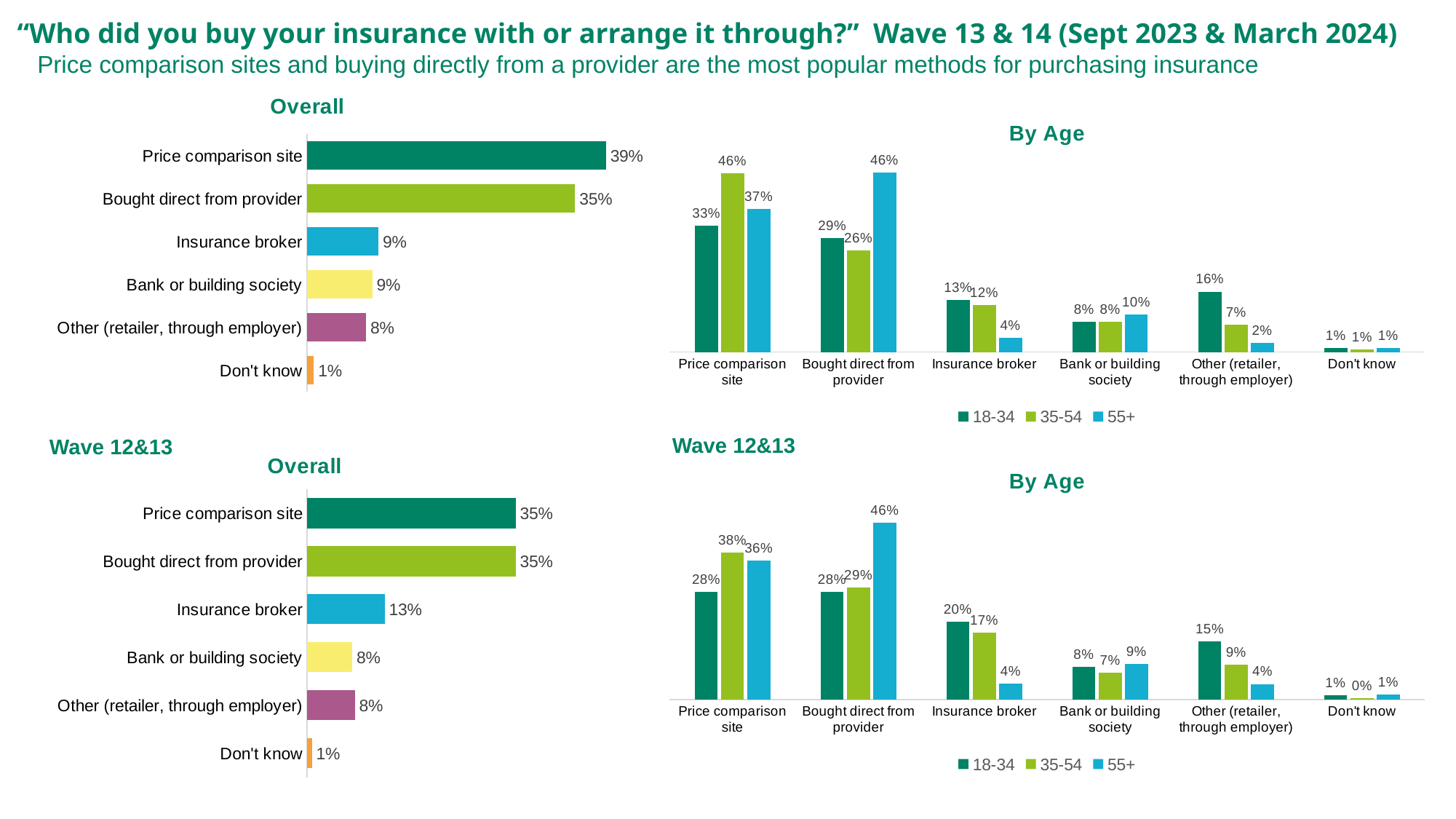
In the bottom-right Wave 12&13 By Age chart, which is larger for Price comparison site: 35-54 or 55+? 35-54 In the bottom-left Wave 12&13 Overall chart, which category has the lowest value? Don't know In the top-left Overall bar chart, what is the value for Price comparison site? 39% In the top-right By Age chart, which age group has the highest value for Other (retailer, through employer)? 18-34 In the bottom-left Wave 12&13 Overall chart, what is the value for Insurance broker? 13% In the top-right By Age chart, what is the value for the 55+ group for Bought direct from provider? 46% How many categories are shown in the top-left Overall bar chart? 6 What type of chart is the top-left Overall chart? Bar chart In the top-left Overall bar chart, which category has the highest value? Price comparison site In the top-right By Age chart, how many series does the legend list? 3 In the bottom-right Wave 12&13 By Age chart, what is the value for the 18-34 group for Insurance broker? 20% In the top-left Overall bar chart, what is the difference between Price comparison site and Bought direct from provider? 4%